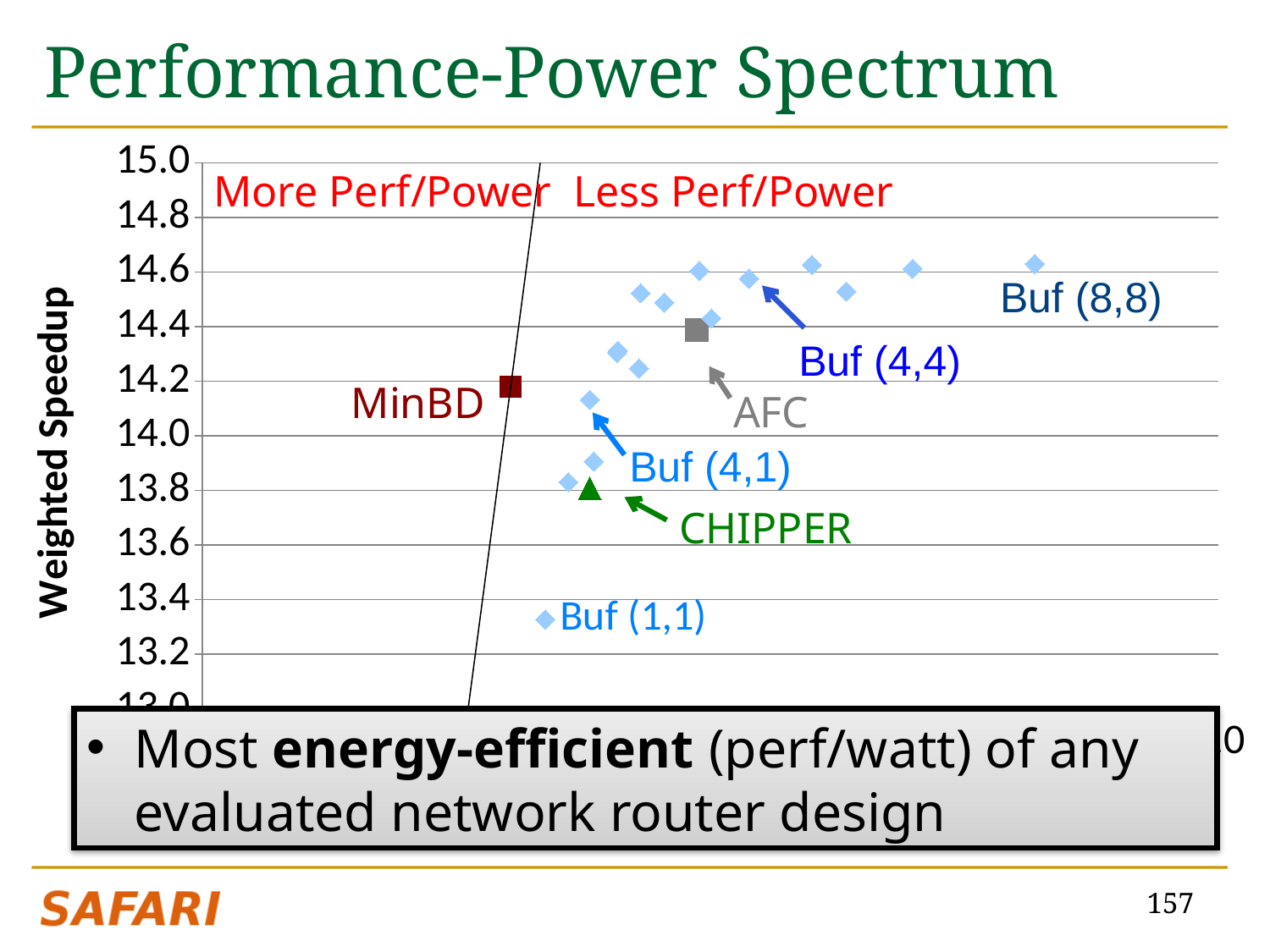
Which side of the diagonal line is labeled "More Perf/Power"? the left side Which has a higher Weighted Speedup, AFC or MinBD? AFC Is the Weighted Speedup for CHIPPER greater or less than 14.0? less Which has a higher Weighted Speedup, MinBD or CHIPPER? MinBD What is the label of the y axis? Weighted Speedup Is the Weighted Speedup for Buf (1,1) greater or less than 13.4? less What kind of chart is shown on the slide? scatter chart Is the Weighted Speedup for MinBD greater or less than 14.0? greater Which has a higher Weighted Speedup, Buf (8,8) or Buf (1,1)? Buf (8,8) Which labeled design has the lowest Weighted Speedup? Buf (1,1)